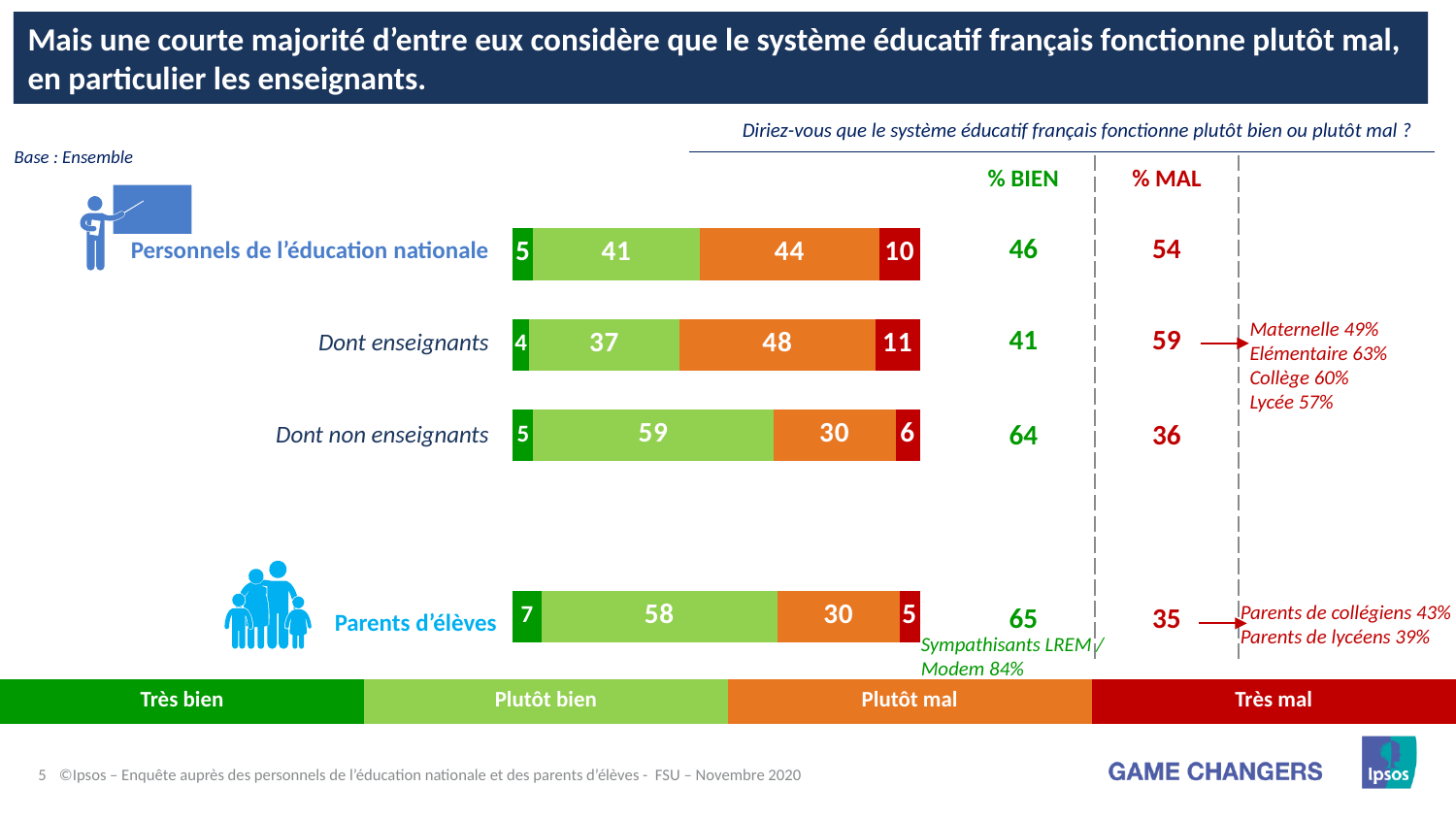
What is the "Très bien" value for "Dont non enseignants"? 5 Which category has the highest "Plutôt bien" value? Dont non enseignants What is the total of the "Très bien" and "Plutôt bien" segments for "Dont enseignants"? 41 Which is larger: the "Plutôt bien" value for "Personnels de l'éducation nationale" or for "Dont enseignants"? Personnels de l'éducation nationale What is the "Plutôt mal" value for "Dont enseignants"? 48 What is the difference between the "Plutôt mal" values for "Dont enseignants" and "Dont non enseignants"? 18 How many series does the legend list? 4 What is the "Très mal" value for "Personnels de l'éducation nationale"? 10 What kind of chart is shown on the slide? Stacked bar chart What is the "Plutôt bien" value for "Parents d'élèves"? 58 How many categories are shown in the chart? 4 Which category has the lowest "Très mal" value? Parents d'élèves